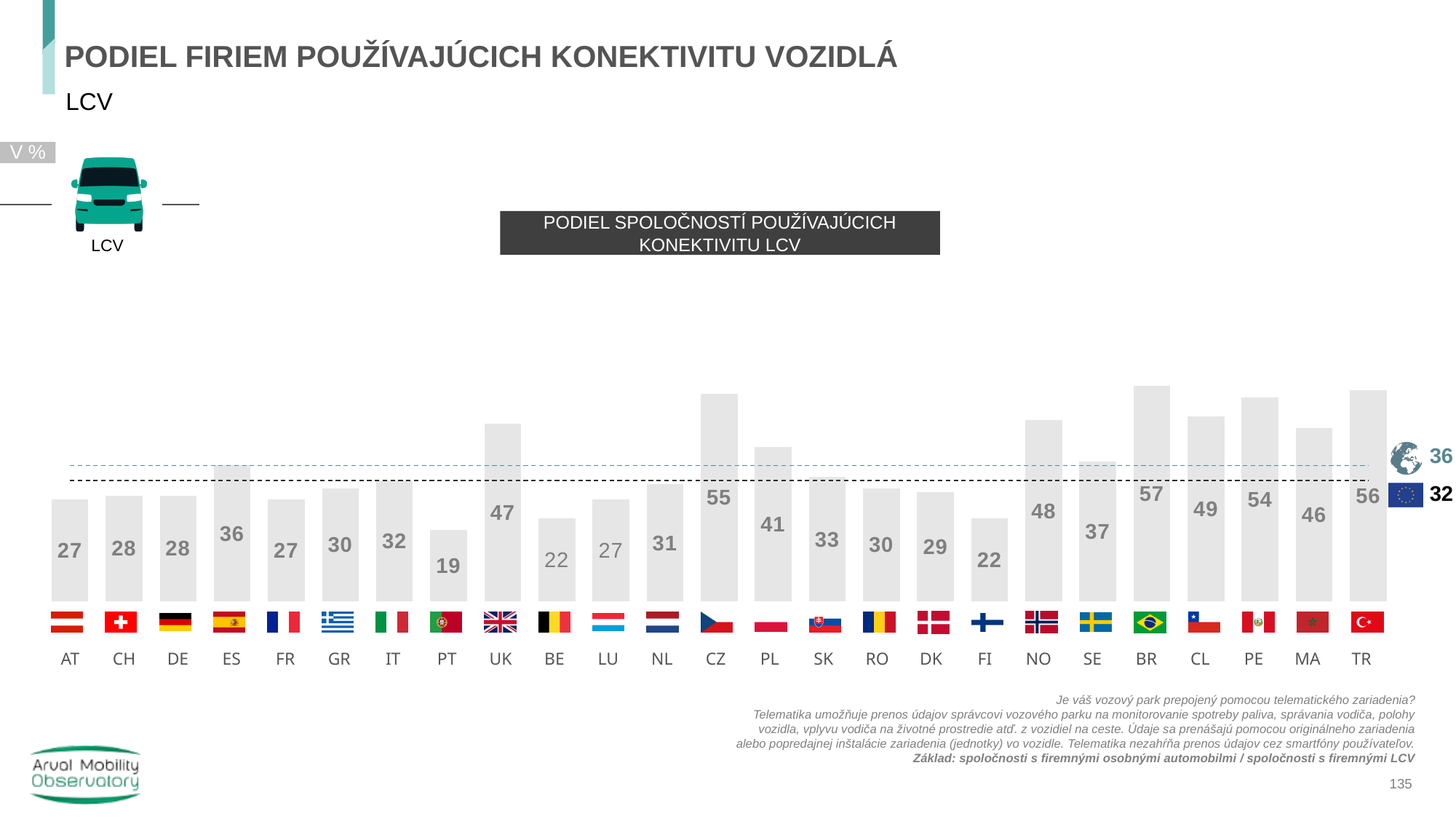
What is the value for NO? 48 What is the value for PT? 19 What is the difference between the values for UK and FR? 20 Which country has the highest value? BR What value is shown next to the globe icon on the right of the chart? 36 What is the value for CZ? 55 How many countries are shown on the chart? 25 Which country has the lowest value? PT What value is shown next to the EU flag on the right of the chart? 32 What kind of chart is shown on the slide? Bar chart What is the difference between the values for BR and PT? 38 Which is larger, the value for PL or the value for SE? PL